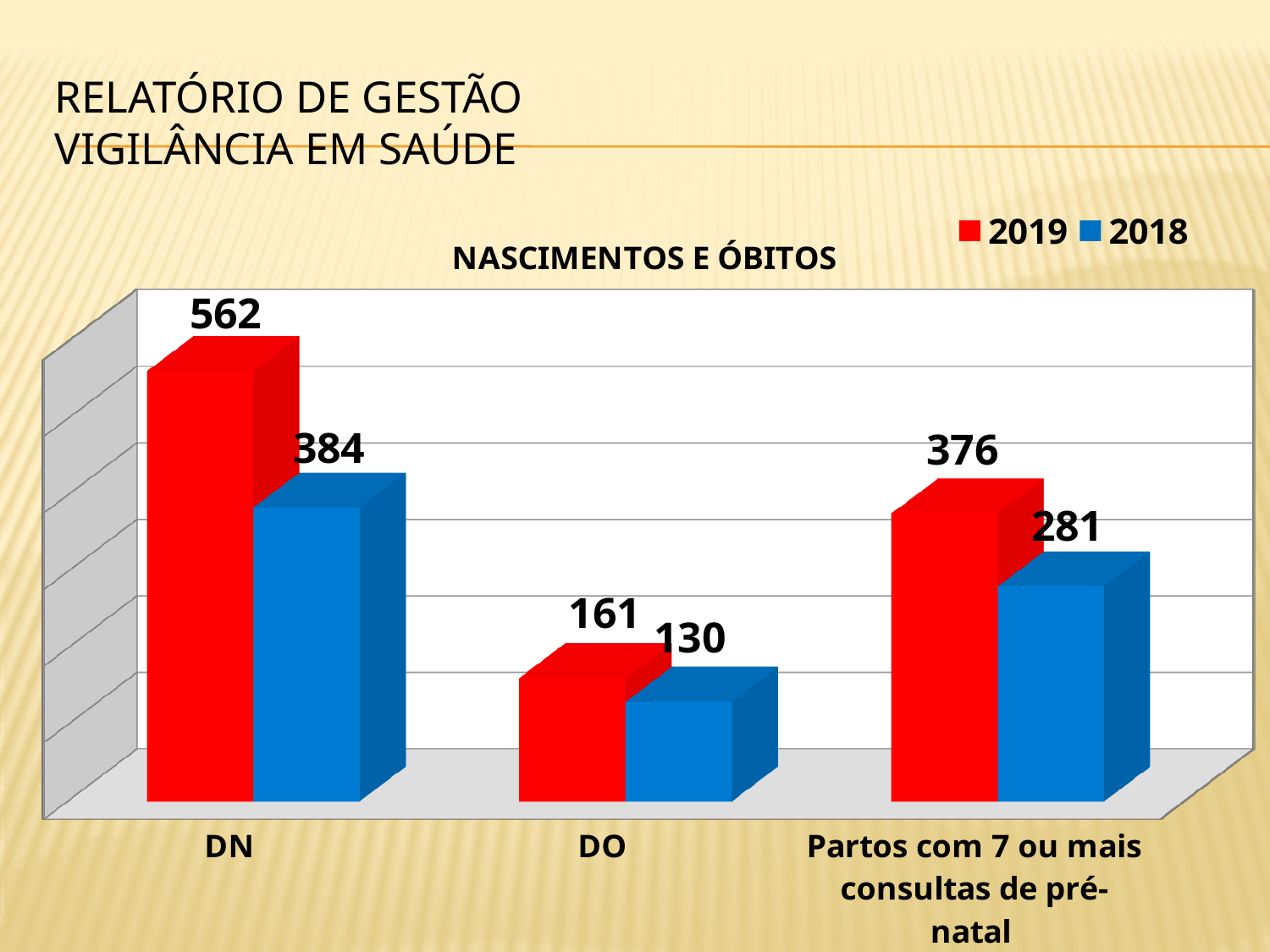
What is the 2019 value for Partos com 7 ou mais consultas de pré-natal? 376 What is the value for DN in 2019? 562 What is the difference between the 2019 and 2018 values for Partos com 7 ou mais consultas de pré-natal? 95 How many categories are shown on the x axis? 3 What is the difference between the 2019 and 2018 values for DN? 178 What is the value for DO in 2018? 130 What is the 2018 value for DN? 384 Which is larger, the 2019 value for DO or the 2018 value for DO? 2019 value for DO Which category has the lowest value in the 2018 series? DO Which category has the highest value in the 2019 series? DN What is the title of the chart? NASCIMENTOS E ÓBITOS How many series does the legend list? 2